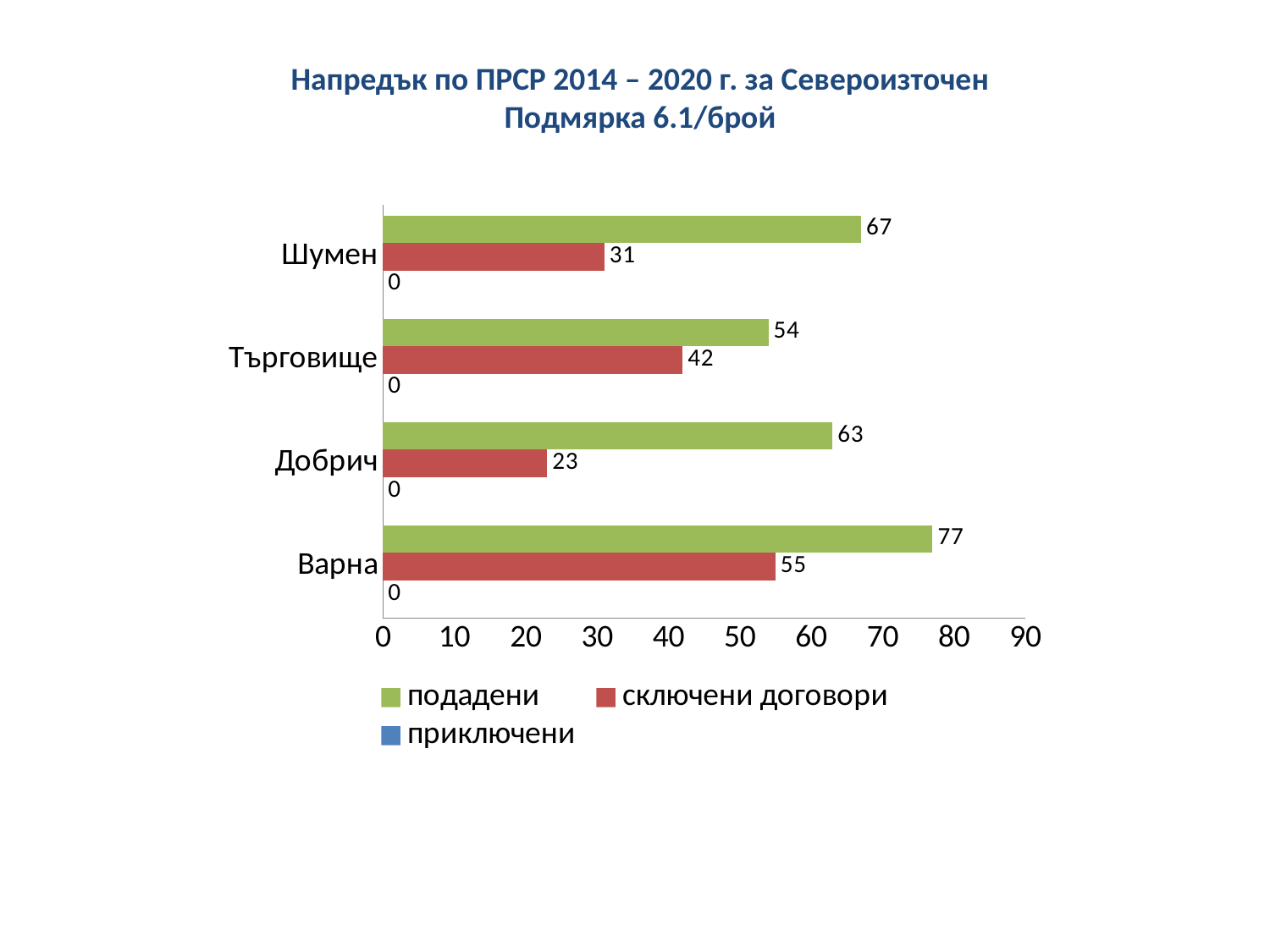
Is the value of подадени for Шумен greater or less than 60? greater Which category has the highest value for подадени? Варна Which category has the lowest value for сключени договори? Добрич What is the difference between подадени and сключени договори for Търговище? 12 What is the value of сключени договори for Добрич? 23 What is the value of приключени for Шумен? 0 How many series does the legend list? 3 What kind of chart is shown on the slide? bar chart Which is larger: сключени договори for Шумен or for Търговище? Търговище How many categories are shown on the chart? 4 What colour are the bars for сключени договори? red What is the value of подадени for Варна? 77